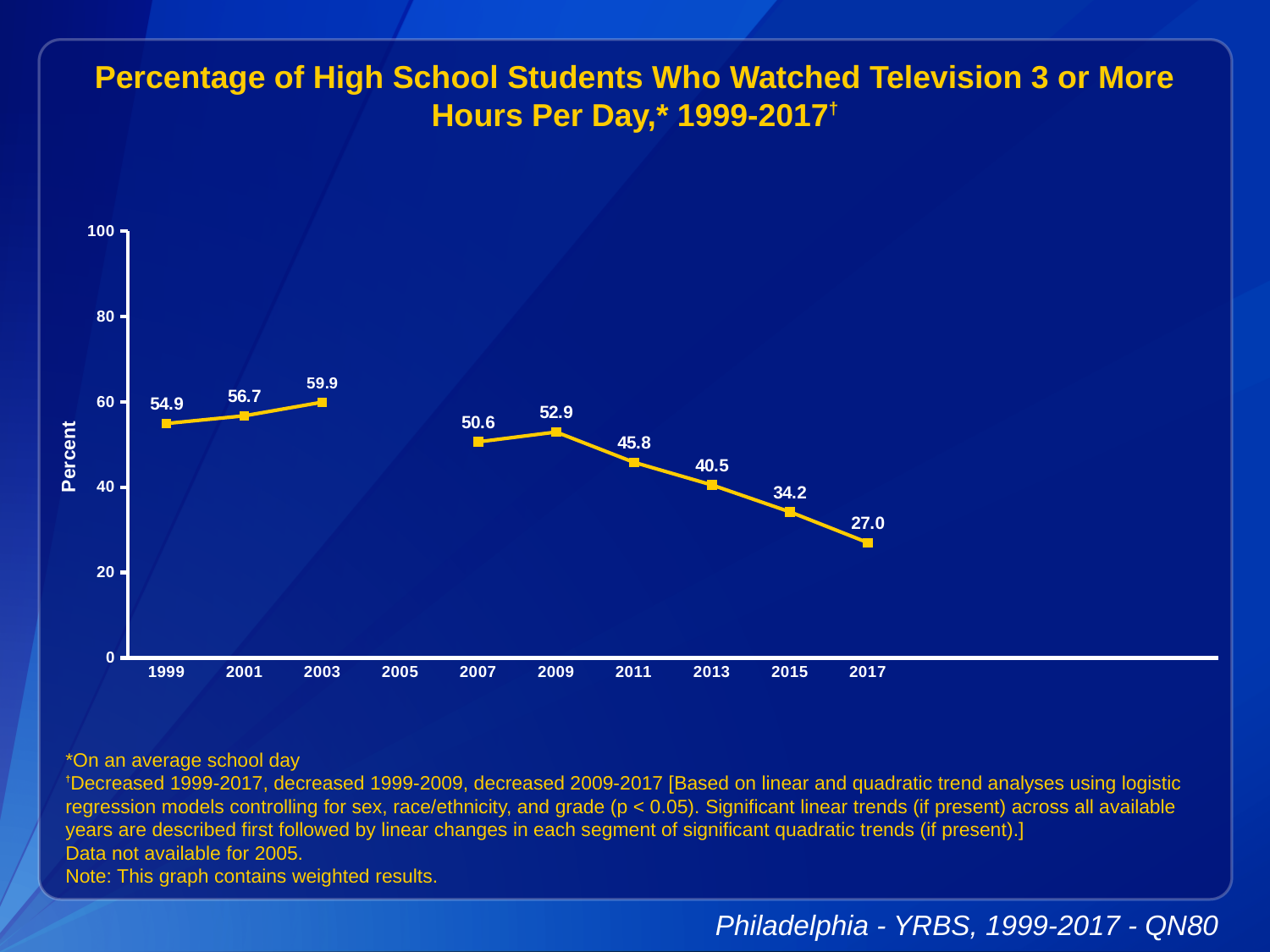
What is the difference between the values for 2003 and 2017? 32.9 Which year has the lowest value on the chart? 2017 What kind of chart is shown on the slide? line chart Do the values rise or fall from 2009 to 2017? fall What is the value plotted for 2009? 52.9 Is the value for 2013 greater or less than 60? less What percentage of high school students watched television 3 or more hours per day in 1999? 54.9 What is the value plotted for 2017? 27.0 How many years have data points plotted on the chart? 9 Which year has the highest value on the chart? 2003 What is the difference between the values for 2007 and 2009? 2.3 Which year has a larger value, 2011 or 2015? 2011